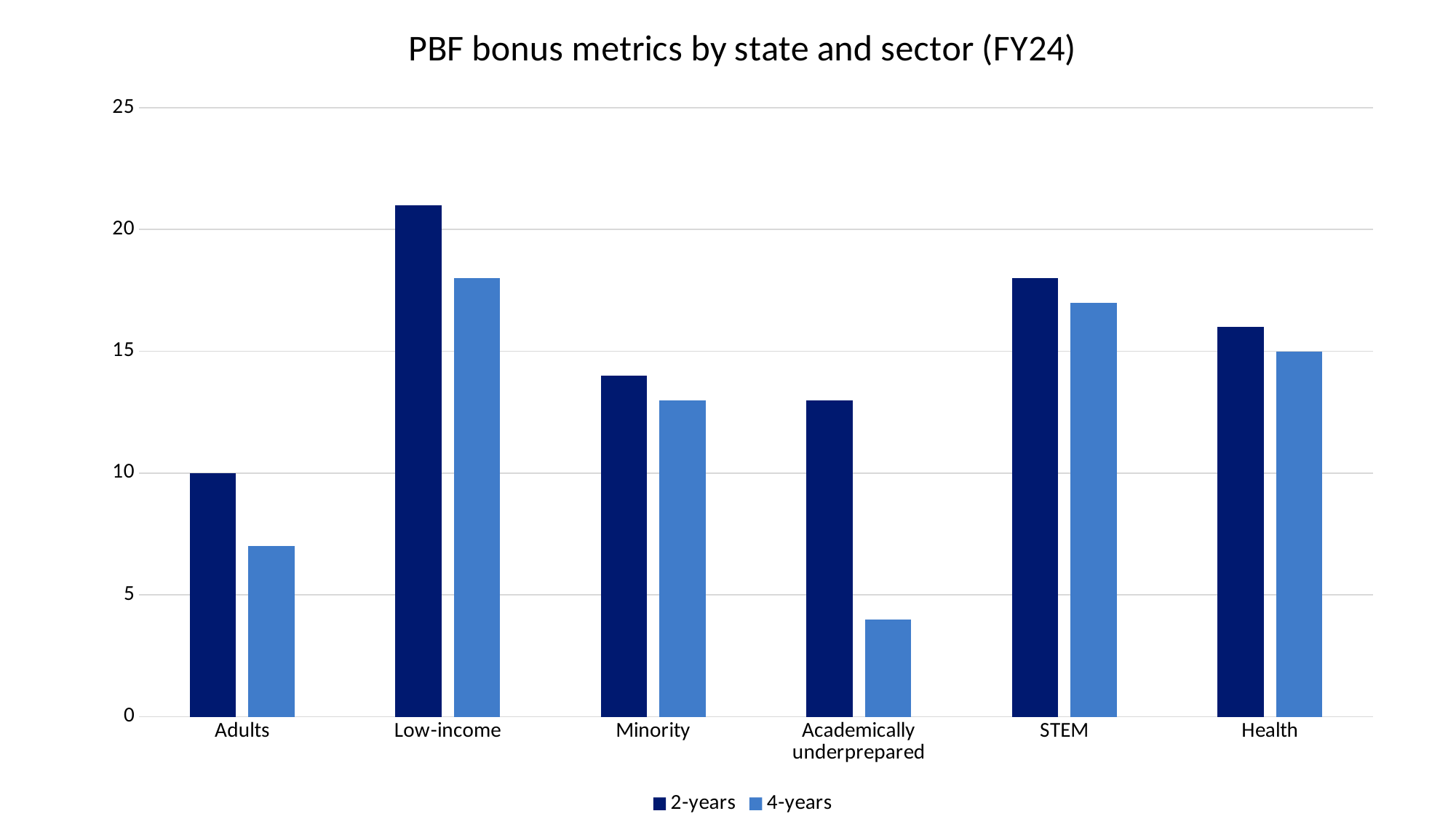
For Academically underprepared, which series has the larger value, 2-years or 4-years? 2-years What kind of chart is shown on the slide? Bar chart How many categories are shown on the x axis? 6 Which category has the lowest value for the 2-years series? Adults How many series does the legend list? 2 Which category has the lowest value for the 4-years series? Academically underprepared What is the title of the chart? PBF bonus metrics by state and sector (FY24) Is the 4-years value for Academically underprepared greater or less than 5? less Is the 2-years value for Low-income greater or less than 20? greater Which category has the highest value for the 2-years series? Low-income Is the 2-years value for STEM greater or less than 15? greater Which series is shown in the darker blue colour? 2-years